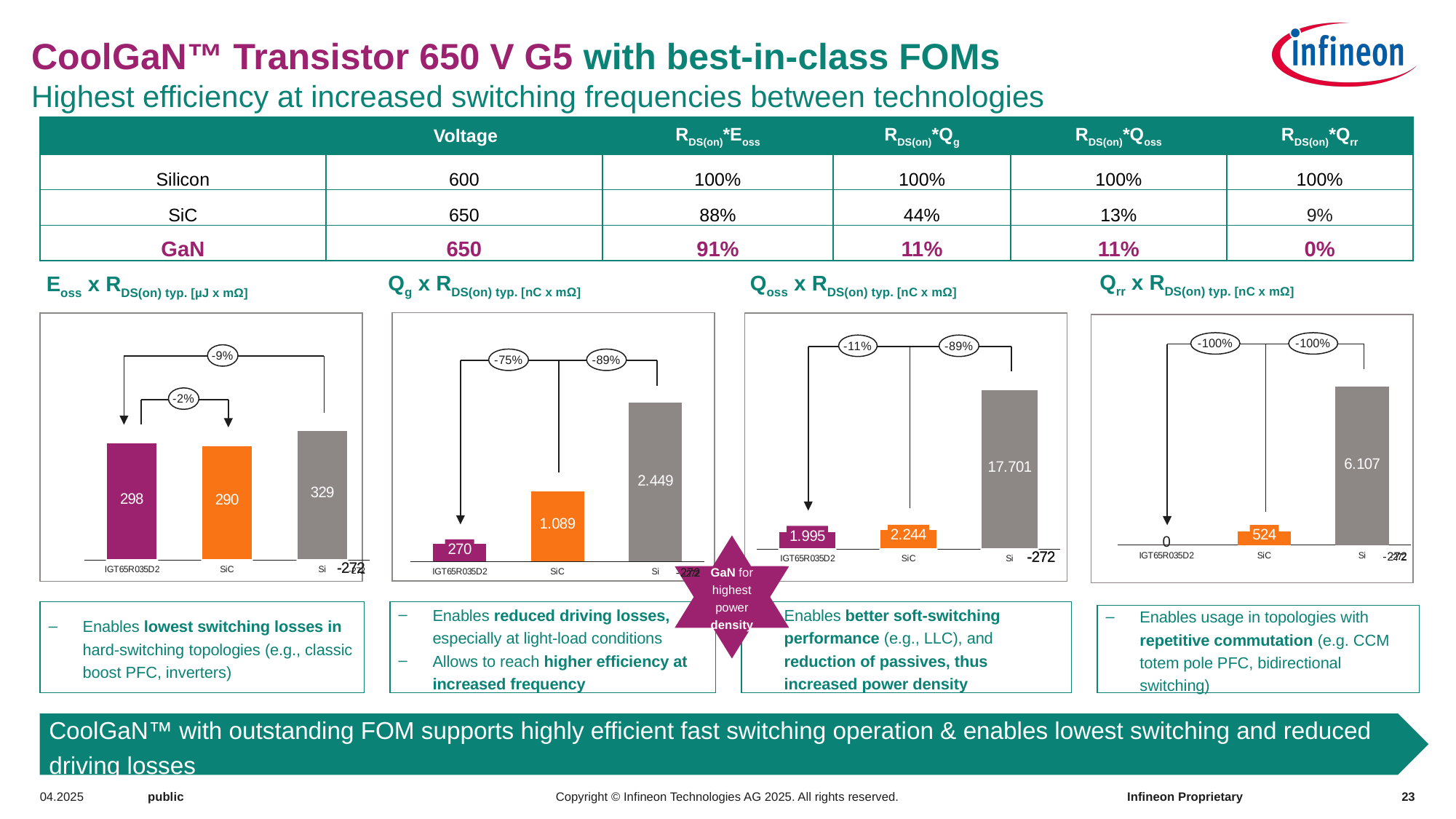
In the Qoss x RDS(on) chart, which is larger, the value for IGT65R035D2 or the value for SiC? SiC In the Qg x RDS(on) chart, what is the value for SiC? 1.089 In the Qoss x RDS(on) chart, what is the value for Si? 17.701 In the Qg x RDS(on) chart, which category has the highest value? Si In the Qrr x RDS(on) chart, what is the value for SiC? 524 In the Eoss x RDS(on) chart, what is the value for IGT65R035D2? 298 In the Eoss x RDS(on) chart, what is the difference between the Si value and the IGT65R035D2 value? 31 In the Eoss x RDS(on) chart, which category has the lowest value? SiC How many categories are shown in the Qoss x RDS(on) chart? 3 What kind of chart is the Qg x RDS(on) chart? Bar chart In the Qrr x RDS(on) chart, what is the value for IGT65R035D2? 0 In the Eoss x RDS(on) chart, what is the value for Si? 329